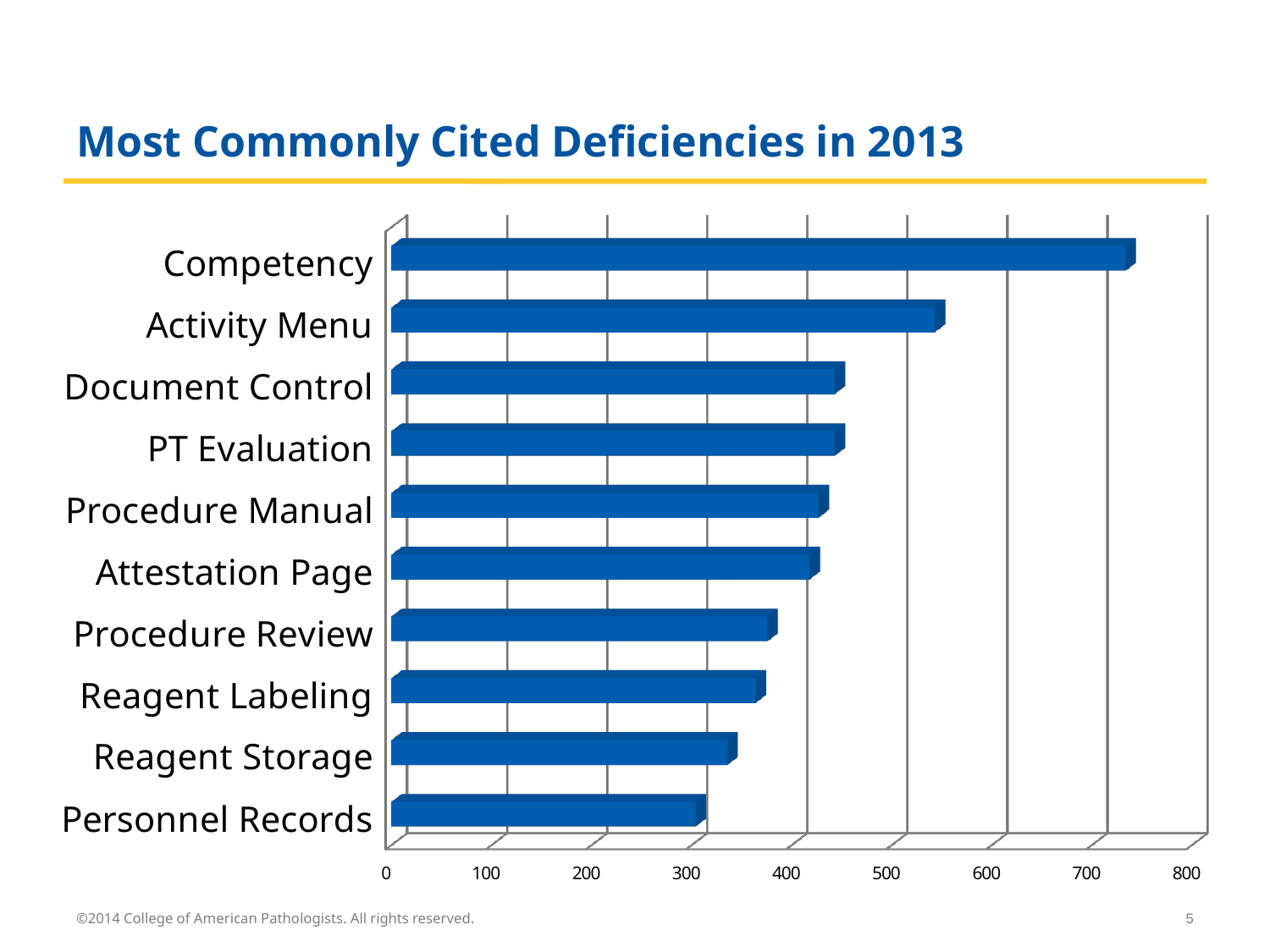
What kind of chart is shown on the slide? Bar chart What is the title of the chart on the slide? Most Commonly Cited Deficiencies in 2013 Is the value for Reagent Storage greater or less than 300? greater Which category has the highest number of cited deficiencies? Competency How many deficiency categories are plotted in the chart? 10 Is the value for Attestation Page greater or less than 400? greater Which has a larger value, Reagent Storage or Personnel Records? Reagent Storage Which category has the lowest number of cited deficiencies? Personnel Records Which has a larger value, Competency or Activity Menu? Competency Is the value for Personnel Records greater or less than 400? less